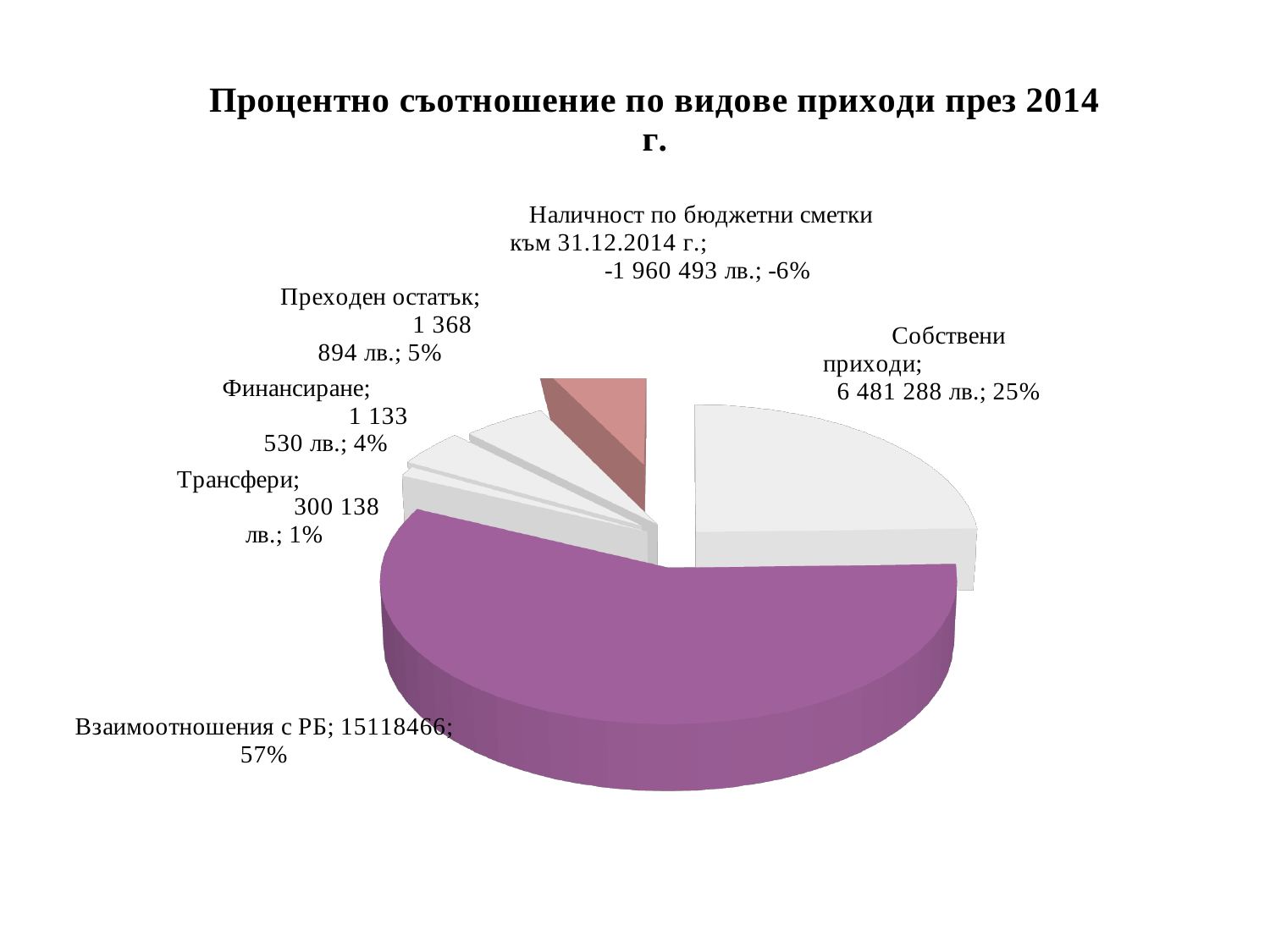
What is the value shown for Преходен остатък? 1 368 894 лв. What share of the pie does Взаимоотношения с РБ represent? 57% Which category has the largest share of the pie? Взаимоотношения с РБ What share of the pie does Собствени приходи represent? 25% How many slices does the pie chart have? 6 What percentage is shown for Наличност по бюджетни сметки към 31.12.2014 г.? -6% What is the value shown for Собствени приходи? 6 481 288 лв. What is the title of the chart? Процентно съотношение по видове приходи през 2014 г. What is the value shown for Трансфери? 300 138 лв. Which is larger, the share for Преходен остатък or the share for Финансиране? Преходен остатък What is the value shown for Финансиране? 1 133 530 лв. What kind of chart is shown on the slide? pie chart